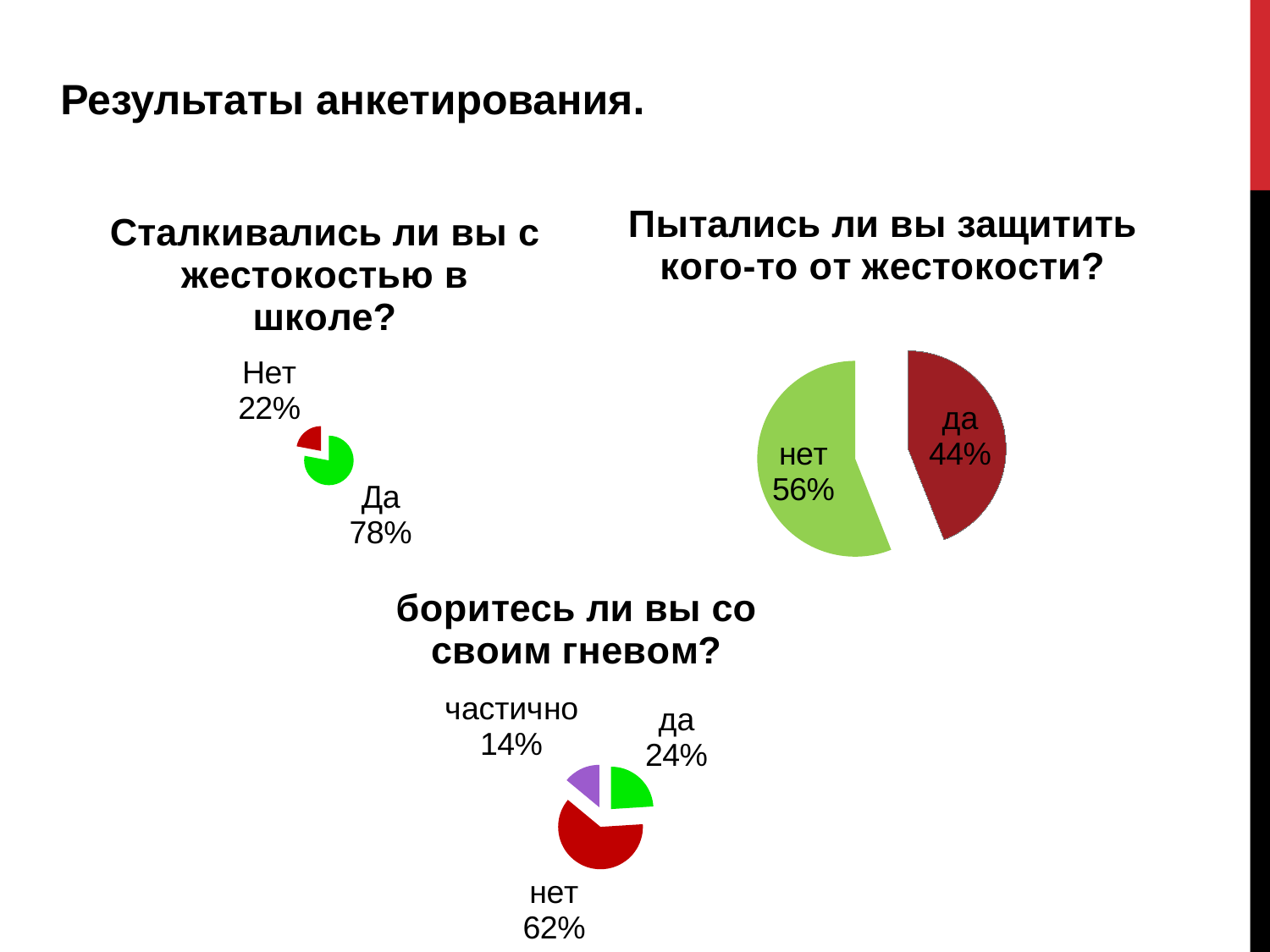
In the chart titled "боритесь ли вы со своим гневом?", which answer has the largest share? нет In the chart titled "боритесь ли вы со своим гневом?", which answer has the smallest share? частично How many charts are shown on the slide? 3 In the chart titled "боритесь ли вы со своим гневом?", how many slices does the pie have? 3 What type of chart is used for "Сталкивались ли вы с жестокостью в школе?"? Pie chart In the chart titled "Пытались ли вы защитить кого-то от жестокости?", what is the value for "нет"? 56% In the chart titled "боритесь ли вы со своим гневом?", what is the value for "частично"? 14% In the chart titled "Пытались ли вы защитить кого-то от жестокости?", what is the difference in percentage points between "нет" and "да"? 12 In the chart titled "боритесь ли вы со своим гневом?", what is the difference in percentage points between "нет" and "да"? 38 In the chart titled "Пытались ли вы защитить кого-то от жестокости?", which answer has the larger share, "да" or "нет"? нет In the chart titled "Сталкивались ли вы с жестокостью в школе?", what share of respondents answered "Нет"? 22% In the chart titled "Сталкивались ли вы с жестокостью в школе?", what share of respondents answered "Да"? 78%